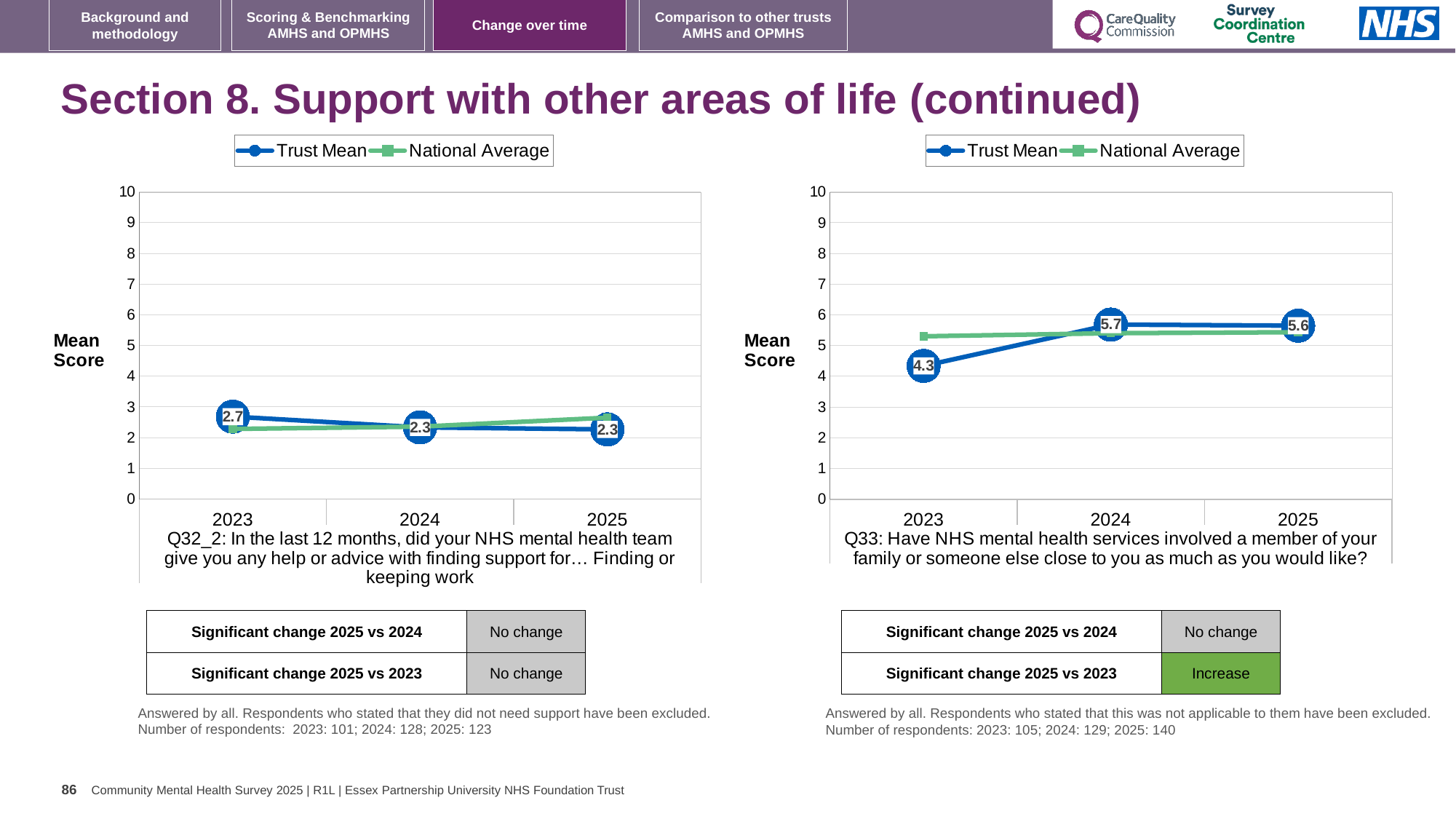
On the left chart (Q32_2), what is the difference between the Trust Mean in 2023 and in 2024? 0.4 On the right chart (Q33), is the Trust Mean for 2023 greater or less than 5? less How many series does the legend of the left chart (Q32_2) list? 2 On the right chart (Q33), what is the Trust Mean for 2023? 4.3 On the left chart (Q32_2), what is the Trust Mean for 2023? 2.7 On the right chart (Q33), is the National Average for 2023 greater or less than 5? greater What kind of chart is the right chart (Q33)? Line chart On the right chart (Q33), in which year is the Trust Mean highest? 2024 On the right chart (Q33), what is the Trust Mean for 2024? 5.7 On the right chart (Q33), in which year is the Trust Mean lowest? 2023 On the right chart (Q33), what is the difference between the Trust Mean in 2024 and in 2023? 1.4 On the left chart (Q32_2), what is the Trust Mean for 2025? 2.3